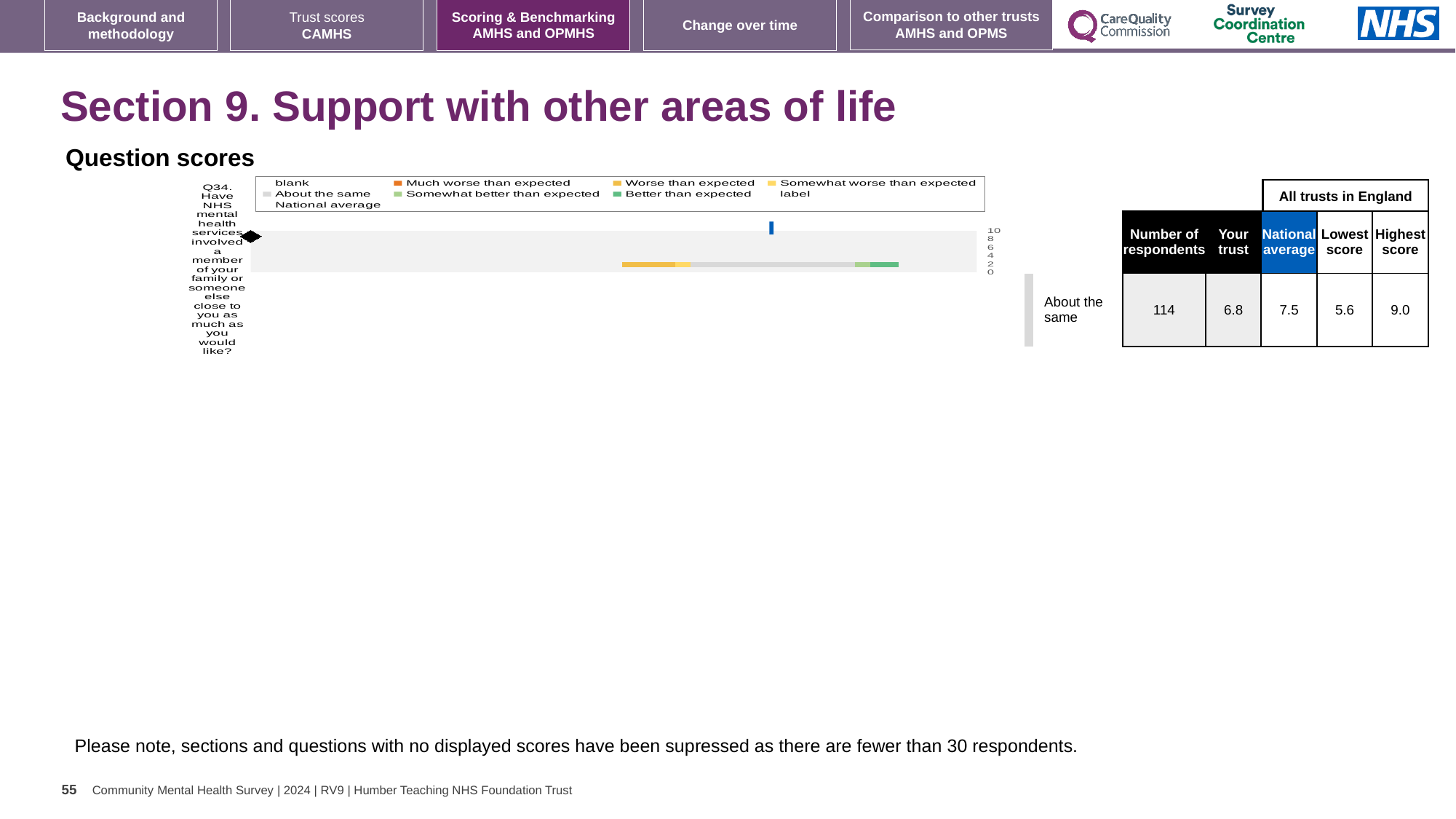
How many questions are plotted in the Question scores chart? 1 What benchmark category is the trust's Q34 result labelled as? About the same What kind of chart is shown under 'Question scores'? bar chart What is the lowest score among all trusts in England for Q34? 5.6 What is the national average score for Q34? 7.5 What is the difference between the highest and lowest scores for Q34? 3.4 What is the highest score among all trusts in England for Q34? 9.0 By how much does the national average exceed the 'Your trust' score for Q34? 0.7 What is the 'Your trust' score for Q34? 6.8 Which is larger for Q34: the 'Your trust' score or the national average? National average How many respondents answered Q34? 114 Which question number is plotted in the Question scores chart? Q34